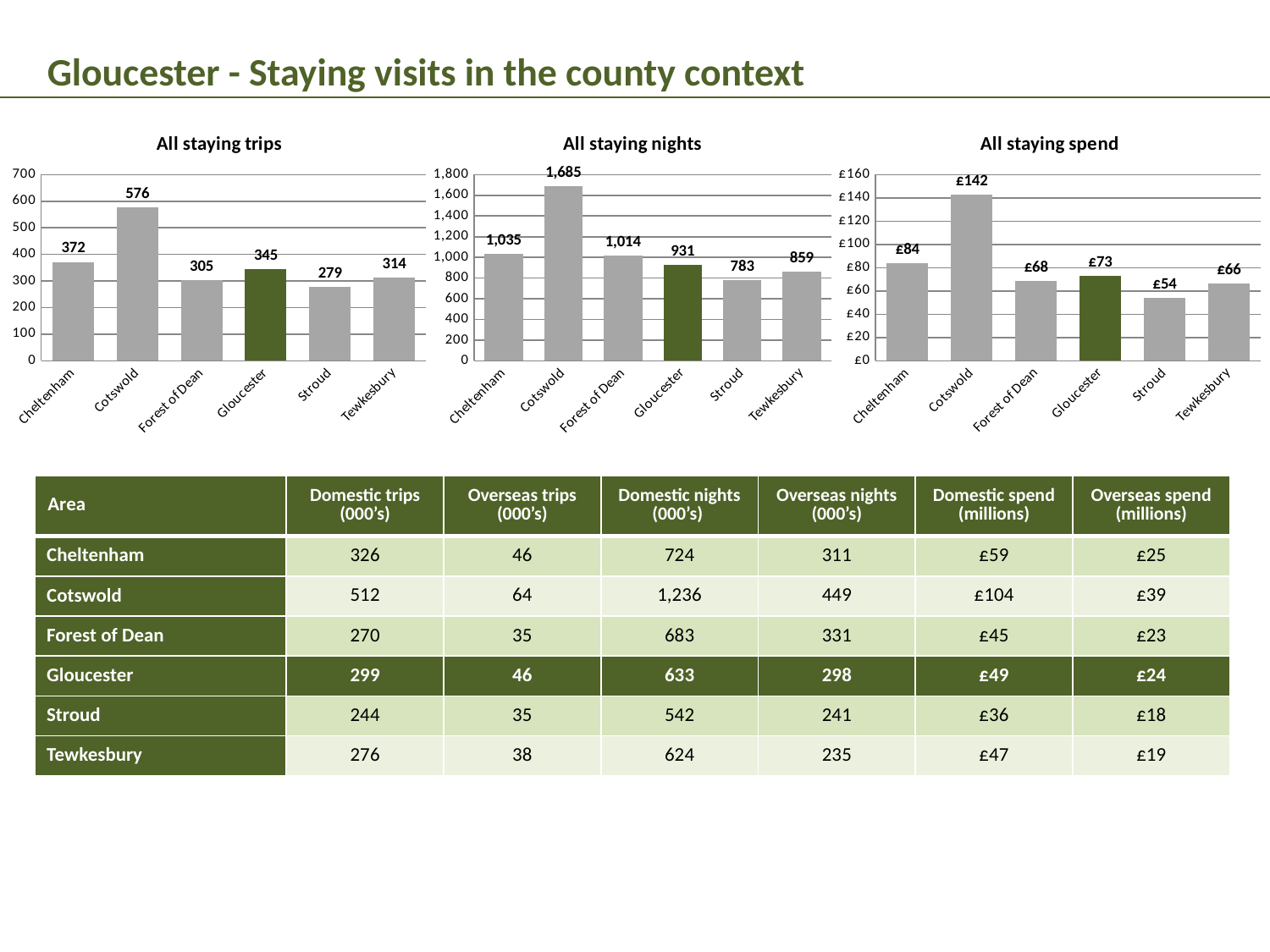
In the 'All staying nights' chart, which is larger, Cheltenham or Forest of Dean? Cheltenham In the 'All staying nights' chart, what is the value for Cotswold? 1,685 What kind of chart is the 'All staying nights' chart? Bar chart In the 'All staying spend' chart, what is the value for Stroud? £54 In the 'All staying trips' chart, what is the difference between Cheltenham and Tewkesbury? 58 In the 'All staying spend' chart, what is the difference between Cotswold and Gloucester? £69 In the 'All staying trips' chart, which area has the highest value? Cotswold In the 'All staying spend' chart, which bar is coloured dark green rather than grey? Gloucester How many areas are shown in the 'All staying trips' chart? 6 In the 'All staying trips' chart, what is the value for Gloucester? 345 In the 'All staying spend' chart, is the value for Cheltenham greater or less than £80? greater In the 'All staying nights' chart, which area has the lowest value? Stroud